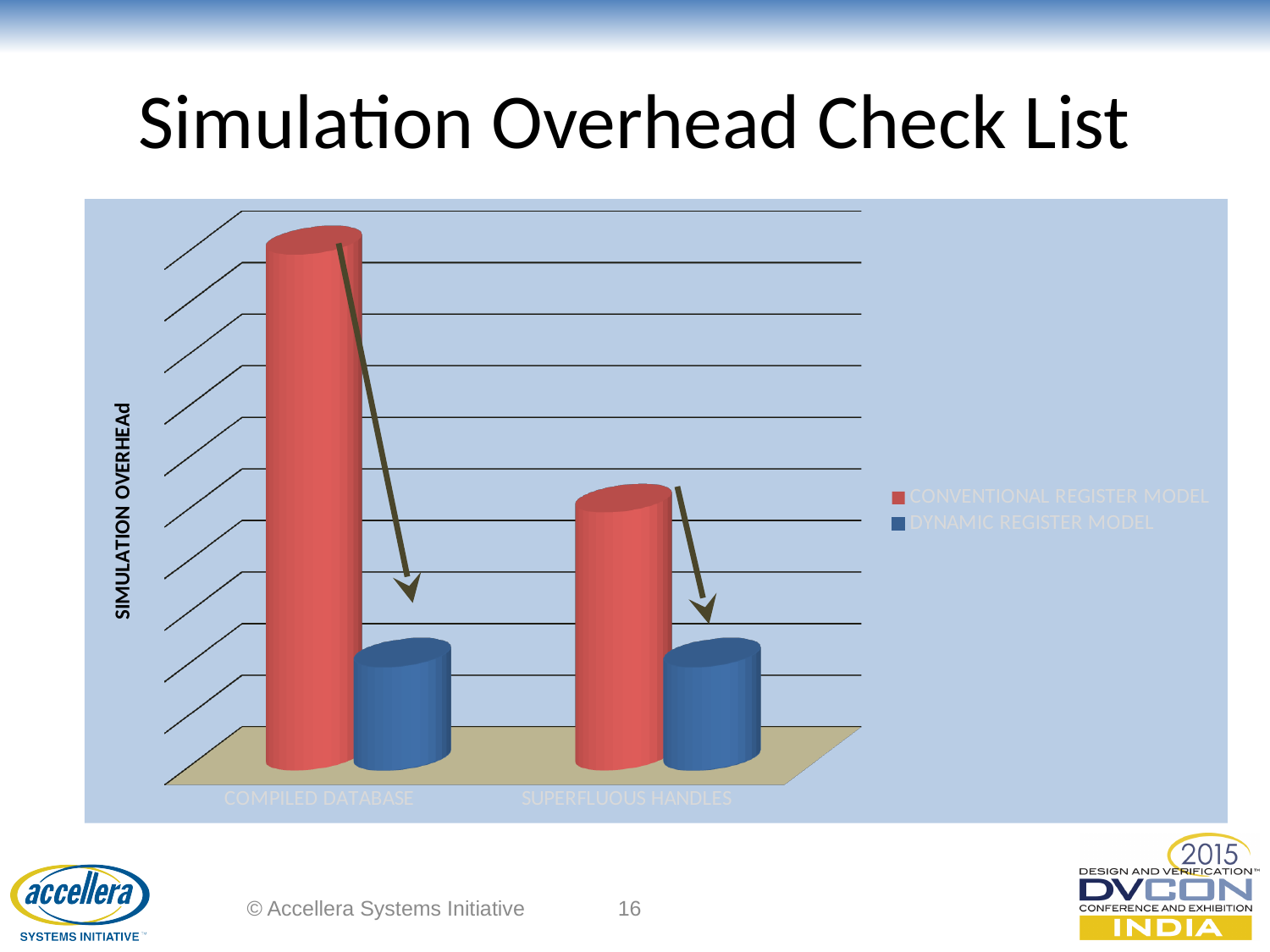
Which series is shown in red in the chart? CONVENTIONAL REGISTER MODEL For the CONVENTIONAL REGISTER MODEL series, which category has the highest value? COMPILED DATABASE Which bar is the tallest in the whole chart? CONVENTIONAL REGISTER MODEL for COMPILED DATABASE Which series has the larger value for COMPILED DATABASE, CONVENTIONAL REGISTER MODEL or DYNAMIC REGISTER MODEL? CONVENTIONAL REGISTER MODEL How many series does the chart's legend list? 2 Which series has the larger value for SUPERFLUOUS HANDLES, CONVENTIONAL REGISTER MODEL or DYNAMIC REGISTER MODEL? CONVENTIONAL REGISTER MODEL What is the label on the vertical axis of the chart? SIMULATION OVERHEAd What kind of chart is shown on the slide? bar chart How many categories are shown on the x axis of the chart? 2 Does the CONVENTIONAL REGISTER MODEL series rise or fall from COMPILED DATABASE to SUPERFLUOUS HANDLES? fall